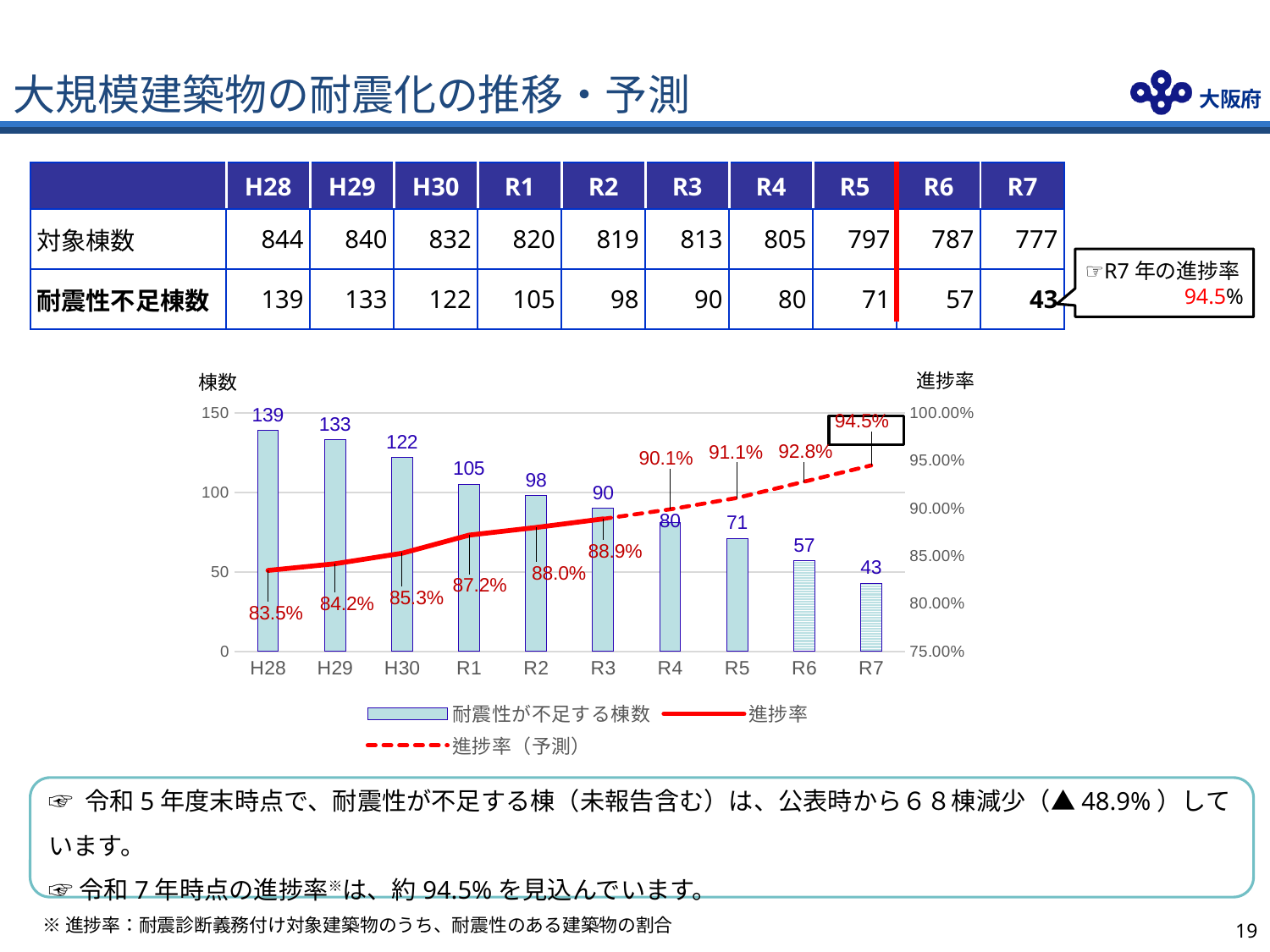
Which is larger in the chart: the 耐震性が不足する棟数 for R1 or for R4? R1 What is the 進捗率 shown for R3 in the chart? 88.9% What is the difference between the 耐震性が不足する棟数 values for H28 and R5 in the chart? 68 Which category has the highest 耐震性が不足する棟数 bar in the chart? H28 Which category has the lowest 耐震性が不足する棟数 bar in the chart? R7 How many categories are shown on the x axis of the chart? 10 What is the value of 耐震性が不足する棟数 for R7 in the chart? 43 Do the 耐震性が不足する棟数 bars rise or fall from H28 to R7 in the chart? Fall What is the 進捗率 value for R7 highlighted in the box on the chart? 94.5% What kind of chart is shown on the slide? Combined bar and line chart How many series does the chart legend list? 3 What is the value of 耐震性が不足する棟数 for H28 in the chart? 139